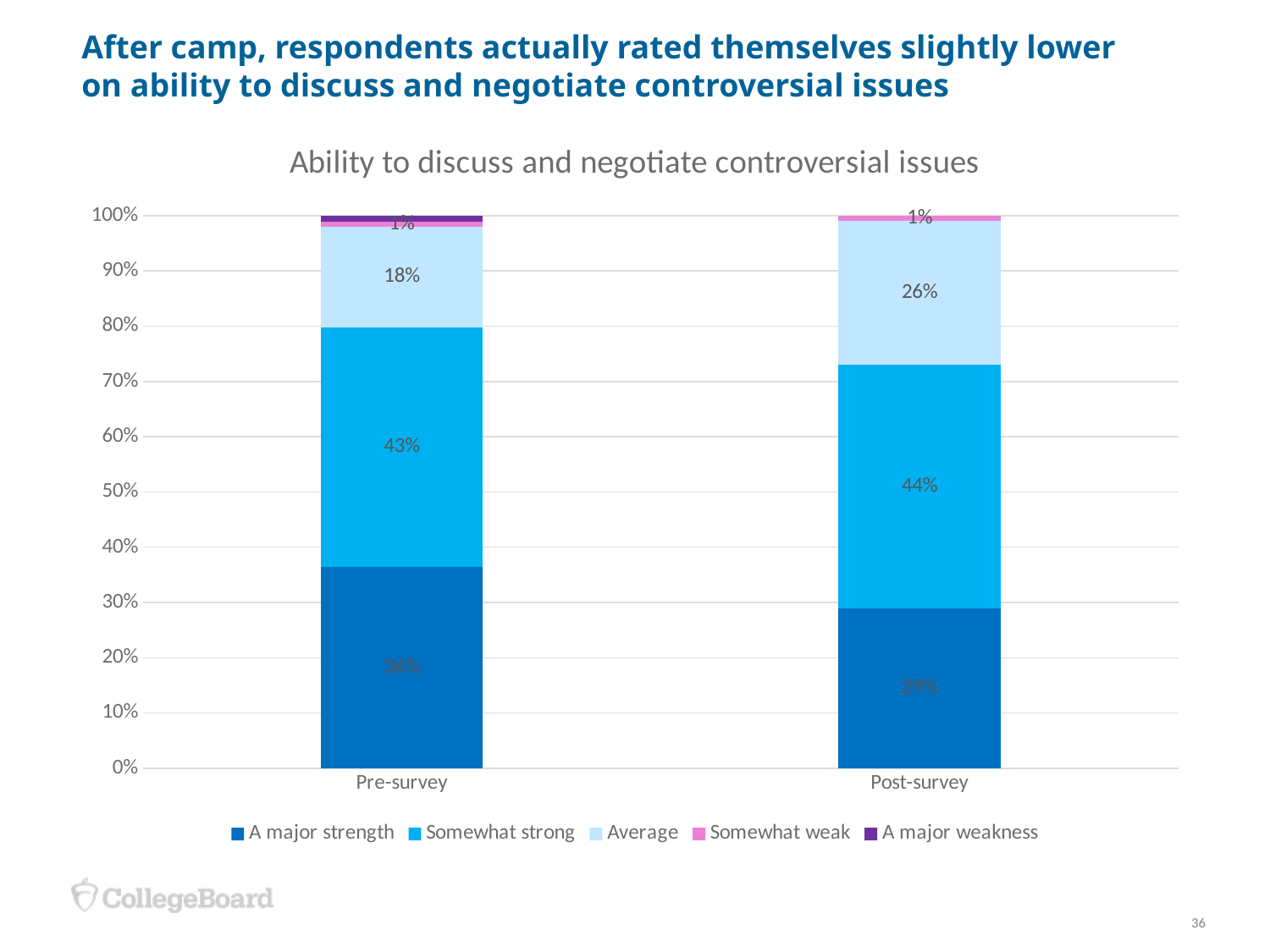
What kind of chart is shown on the slide? Stacked bar chart What percentage of Post-survey respondents rated this ability as 'A major strength'? 29% By how many percentage points did the 'A major strength' share drop from Pre-survey to Post-survey? 7 percentage points What percentage of Pre-survey respondents rated this ability as 'A major strength'? 36% How many series does the legend list? 5 How many categories are shown on the x axis? 2 By how many percentage points did the 'Average' share increase from Pre-survey to Post-survey? 8 percentage points What is the 'Somewhat strong' value for the Pre-survey bar? 43% Which bar has the larger 'Average' share, Pre-survey or Post-survey? Post-survey What is the 'Average' value for the Post-survey bar? 26% Which bar has the larger 'A major strength' share, Pre-survey or Post-survey? Pre-survey What is the 'Somewhat weak' value for the Post-survey bar? 1%